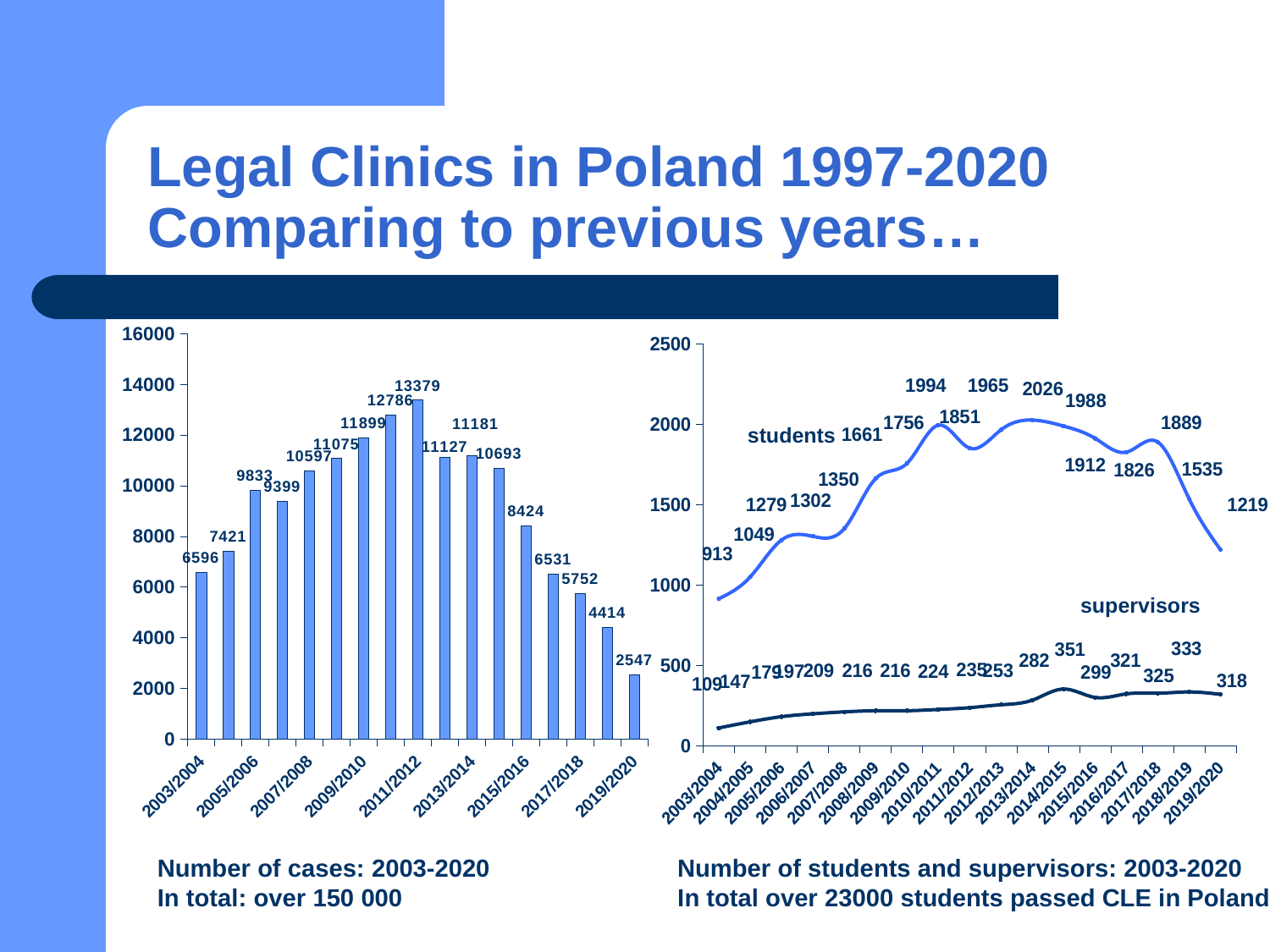
In the left chart (Number of cases), what is the difference between the values for 2011/2012 and 2019/2020? 10832 What kind of chart is the left chart (Number of cases: 2003-2020)? bar chart What kind of chart is the right chart (Number of students and supervisors)? line chart In the left chart (Number of cases), what is the value for 2019/2020? 2547 In the left chart (Number of cases), what is the value for 2003/2004? 6596 In the left chart (Number of cases), do the values rise or fall from 2011/2012 to 2019/2020? fall How many bars are plotted in the left chart (Number of cases)? 17 How many series are plotted in the right chart (Number of students and supervisors)? 2 In the left chart (Number of cases), which year has the highest number of cases? 2011/2012 In the right chart, what is the supervisors value for 2019/2020? 318 In the right chart, what is the students value for 2003/2004? 913 In the right chart, what is the highest value of the students series? 2026